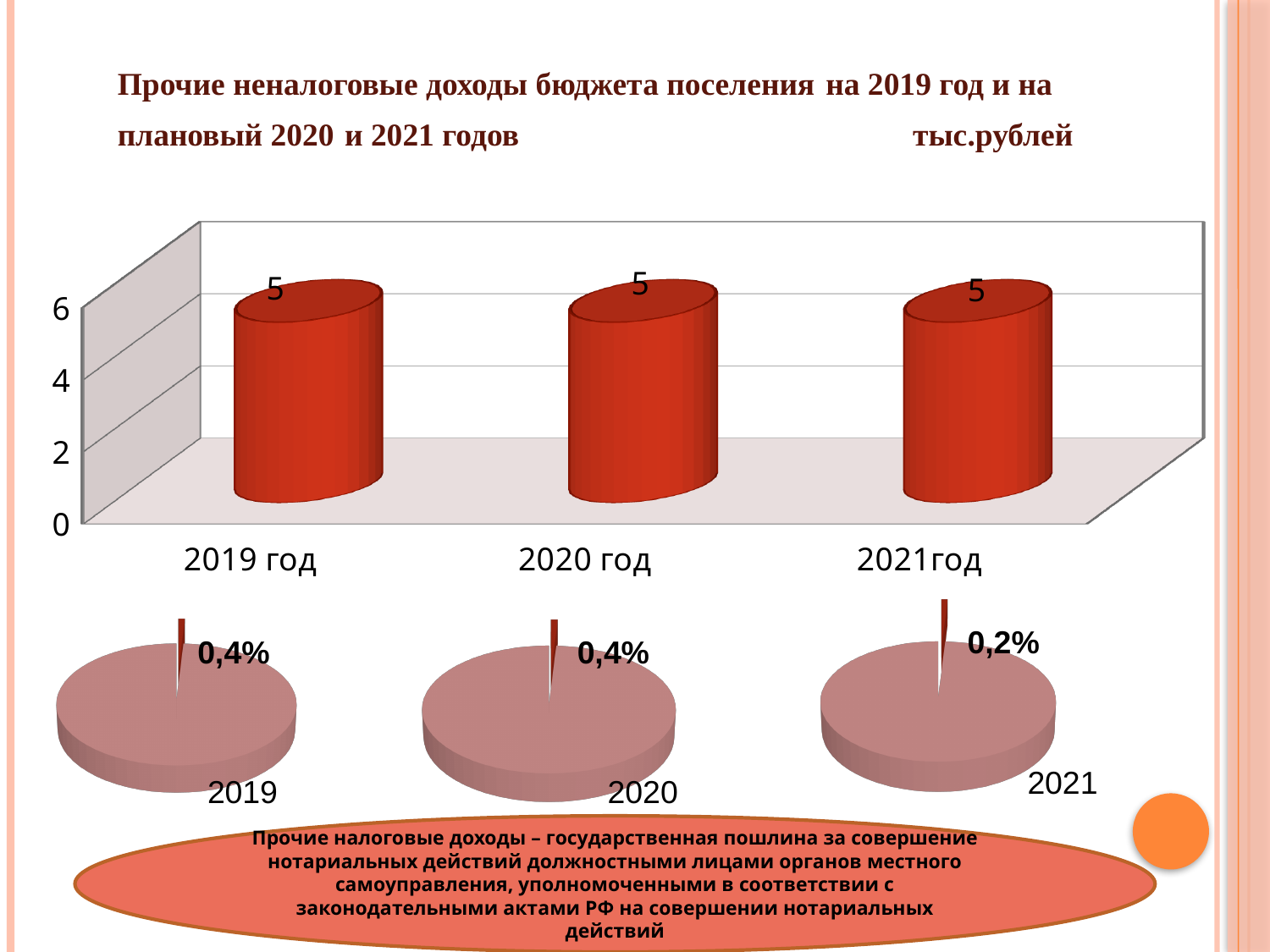
In the bar chart at the top of the slide, what is the value for 2019 год? 5 In the bar chart at the top of the slide, do the values rise, fall or stay the same from 2019 год to 2021 год? stay the same In the bar chart at the top of the slide, what is the value for 2020 год? 5 How many categories are shown in the bar chart at the top of the slide? 3 In the bar chart at the top of the slide, what is the value for 2021 год? 5 In the bar chart at the top of the slide, is the value for 2020 год greater or less than 4? greater What kind of chart is the chart at the top of the slide? bar chart Comparing the pie charts at the bottom of the slide, which year has the smaller labelled share: 2020 or 2021? 2021 In the pie chart for 2021 at the bottom right of the slide, what share is labelled on the small slice? 0,2% In the bar chart at the top of the slide, what is the difference between the values for 2019 год and 2021 год? 0 What unit is stated in the title of the bar chart at the top of the slide? тыс.рублей In the pie chart for 2019 at the bottom left of the slide, what share is labelled on the small slice? 0,4%